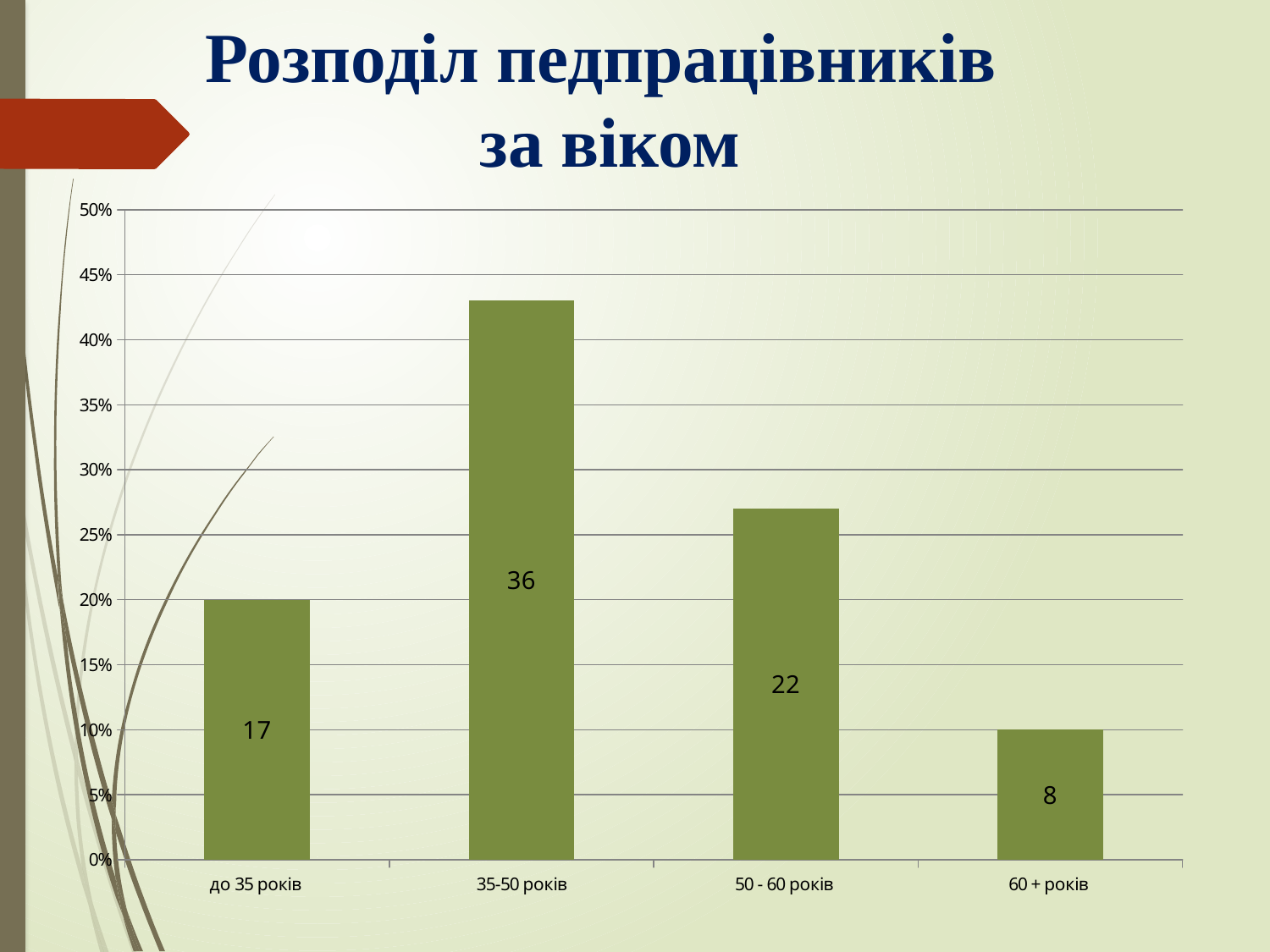
Which age category has the lowest bar? 60 + років What is the title of the chart on the slide? Розподіл педпрацівників за віком What is the data label shown on the bar for 35-50 років? 36 Is the value for 60 + років greater or less than 15%? less Which is larger, the bar for до 35 років or the bar for 50 - 60 років? 50 - 60 років What is the data label shown on the bar for до 35 років? 17 What kind of chart is shown on the slide? bar chart Is the value for 35-50 років greater or less than 40%? greater Which age category has the highest bar? 35-50 років What is the data label shown on the bar for 60 + років? 8 How many age categories are shown on the x axis? 4 What is the difference between the data labels for 35-50 років and 50 - 60 років? 14